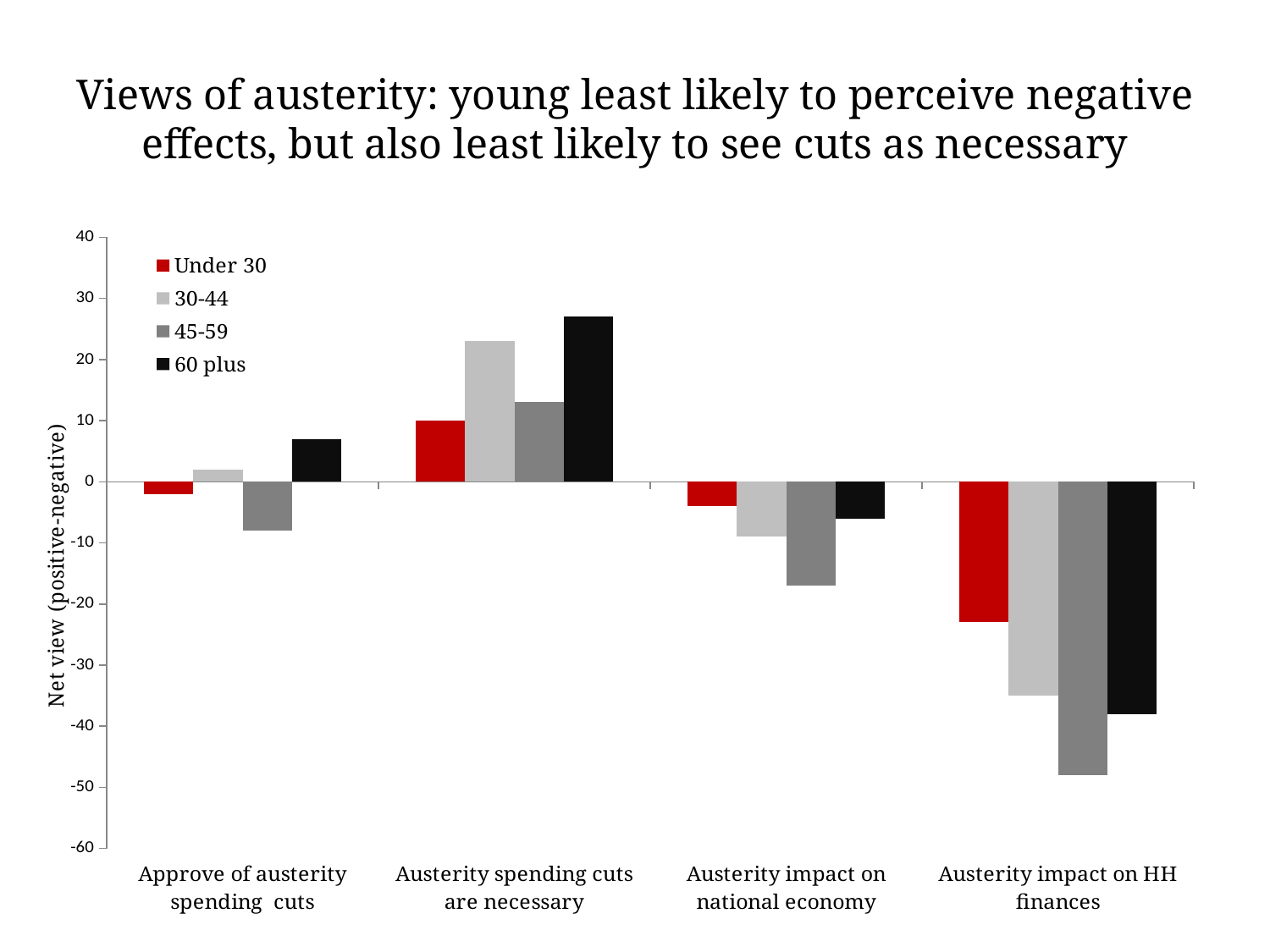
What is the label on the y axis? Net view (positive-negative) What kind of chart is shown on the slide? Bar chart Is the value for 45-59 on "Austerity impact on HH finances" greater or less than -40? less How many series does the legend list? 4 Is the value for 45-59 on "Austerity impact on national economy" greater or less than -10? less How many categories are shown along the x axis? 4 Which age group has the lowest value for "Austerity impact on HH finances"? 45-59 For "Austerity impact on national economy", which is larger: the value for 30-44 or for 45-59? 30-44 For "Approve of austerity spending cuts", which is larger: the value for Under 30 or for 60 plus? 60 plus Which age group has the highest value for "Austerity spending cuts are necessary"? 60 plus Which age group has the lowest value for "Approve of austerity spending cuts"? 45-59 Is the value for 60 plus on "Austerity spending cuts are necessary" greater or less than 20? greater